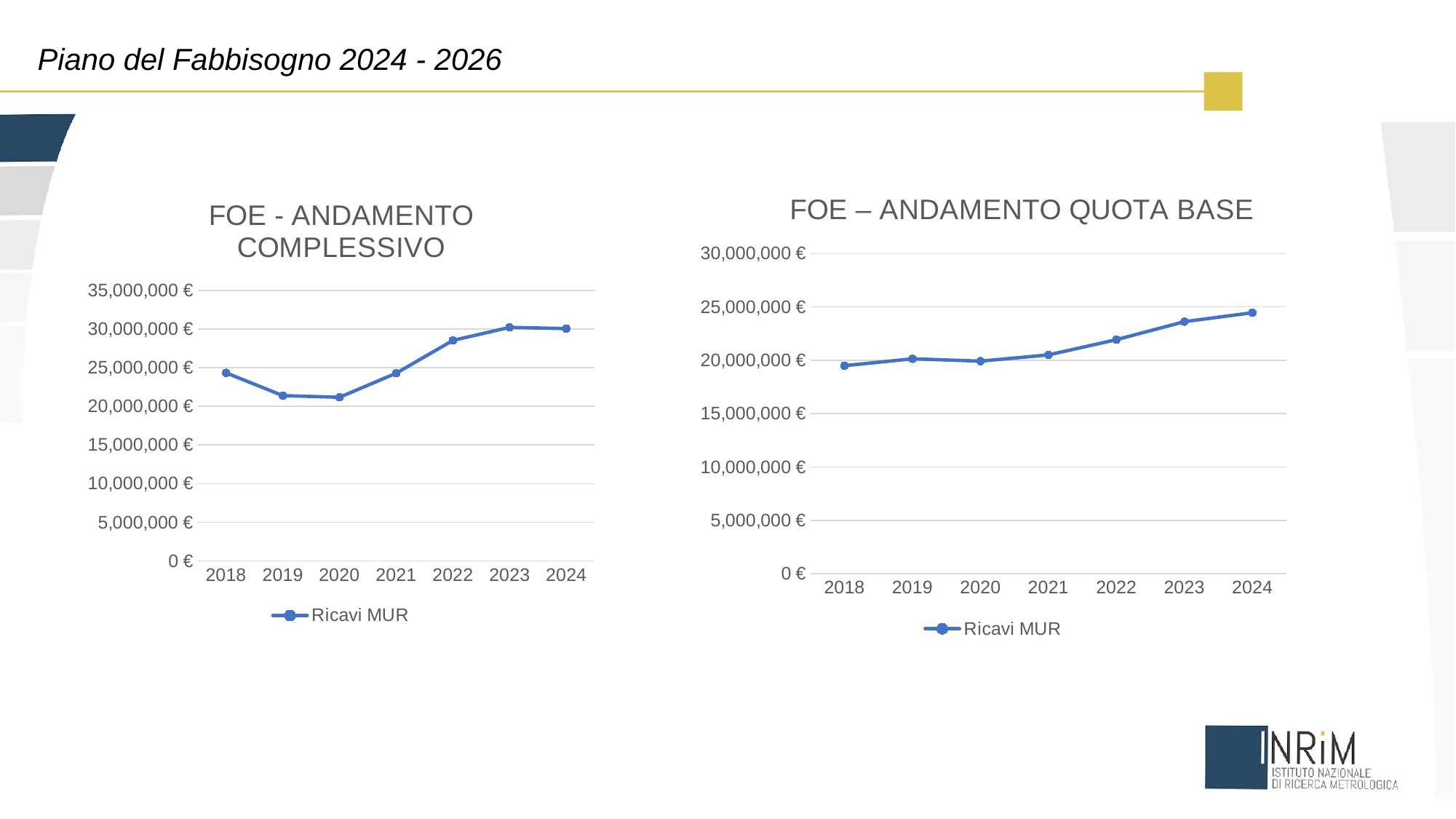
In the 'FOE - ANDAMENTO COMPLESSIVO' chart, is the value for 2019 greater or less than 25,000,000 €? less What is the name of the series shown in the legend of the 'FOE – ANDAMENTO QUOTA BASE' chart? Ricavi MUR What kind of chart is the 'FOE - ANDAMENTO COMPLESSIVO' chart on the left? line chart In the 'FOE – ANDAMENTO QUOTA BASE' chart, which is larger, the value for 2023 or the value for 2021? 2023 In the 'FOE – ANDAMENTO QUOTA BASE' chart, do the values generally rise or fall from 2018 to 2024? rise In the 'FOE - ANDAMENTO COMPLESSIVO' chart, how many years are plotted on the x axis? 7 In the 'FOE – ANDAMENTO QUOTA BASE' chart, is the value for 2024 greater or less than 25,000,000 €? less In the 'FOE – ANDAMENTO QUOTA BASE' chart, which year has the highest value? 2024 In the 'FOE - ANDAMENTO COMPLESSIVO' chart, which is larger, the value for 2023 or the value for 2020? 2023 In the 'FOE - ANDAMENTO COMPLESSIVO' chart, is the value for 2022 greater or less than 25,000,000 €? greater In the 'FOE - ANDAMENTO COMPLESSIVO' chart, how many series does the legend list? 1